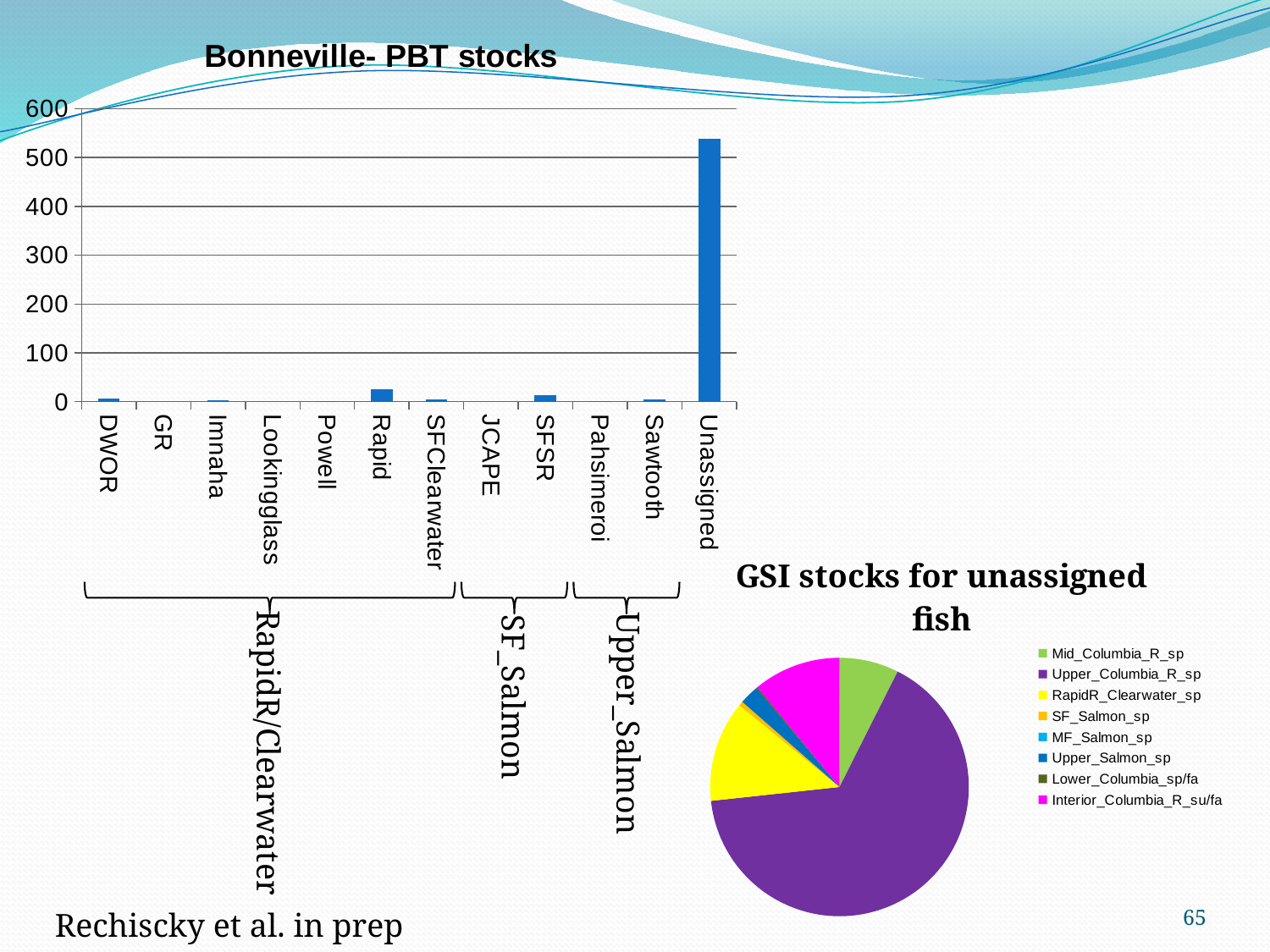
In the 'GSI stocks for unassigned fish' pie chart, which stock has the largest slice? Upper_Columbia_R_sp In the 'Bonneville- PBT stocks' chart, is the value for Unassigned greater or less than 500? greater How many categories are shown on the x axis of the 'Bonneville- PBT stocks' chart? 12 What kind of chart is the 'Bonneville- PBT stocks' chart? bar chart In the 'Bonneville- PBT stocks' chart, is the value for Rapid greater or less than 100? less In the 'Bonneville- PBT stocks' chart, is the value for Unassigned greater or less than 600? less In the 'Bonneville- PBT stocks' chart, which is larger, the value for Unassigned or the value for Rapid? Unassigned How many entries does the legend of the 'GSI stocks for unassigned fish' pie chart list? 8 In the 'Bonneville- PBT stocks' chart, which category has the highest value? Unassigned In the 'Bonneville- PBT stocks' chart, which is larger, the value for Rapid or the value for SFSR? Rapid What kind of chart is the 'GSI stocks for unassigned fish' chart? pie chart In the 'GSI stocks for unassigned fish' pie chart, what colour is the Upper_Columbia_R_sp slice? purple